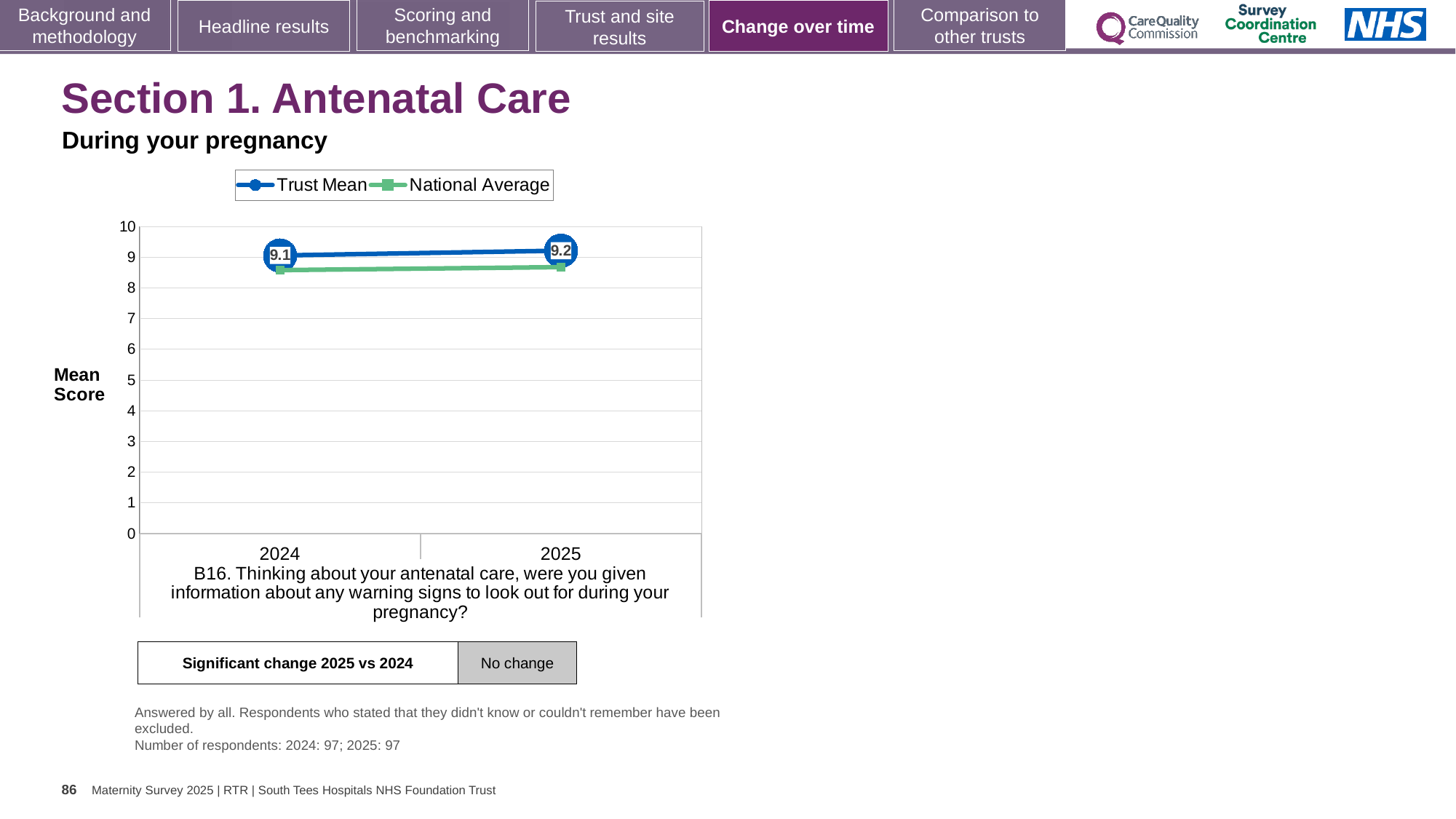
Does the Trust Mean rise or fall from 2024 to 2025? Rise Is the National Average value for 2025 greater or less than 8? greater What are the two series named in the chart legend? Trust Mean and National Average Is the National Average value for 2024 greater or less than 9? less How many series does the chart legend list? 2 In 2025, which is higher, the Trust Mean or the National Average? Trust Mean How many years are plotted on the x axis of the chart? 2 Which year has the higher Trust Mean score, 2024 or 2025? 2025 By how much did the Trust Mean change from 2024 to 2025? 0.1 What is the Trust Mean score for 2025? 9.2 What is the Trust Mean score for 2024? 9.1 What kind of chart is shown on the slide? Line chart